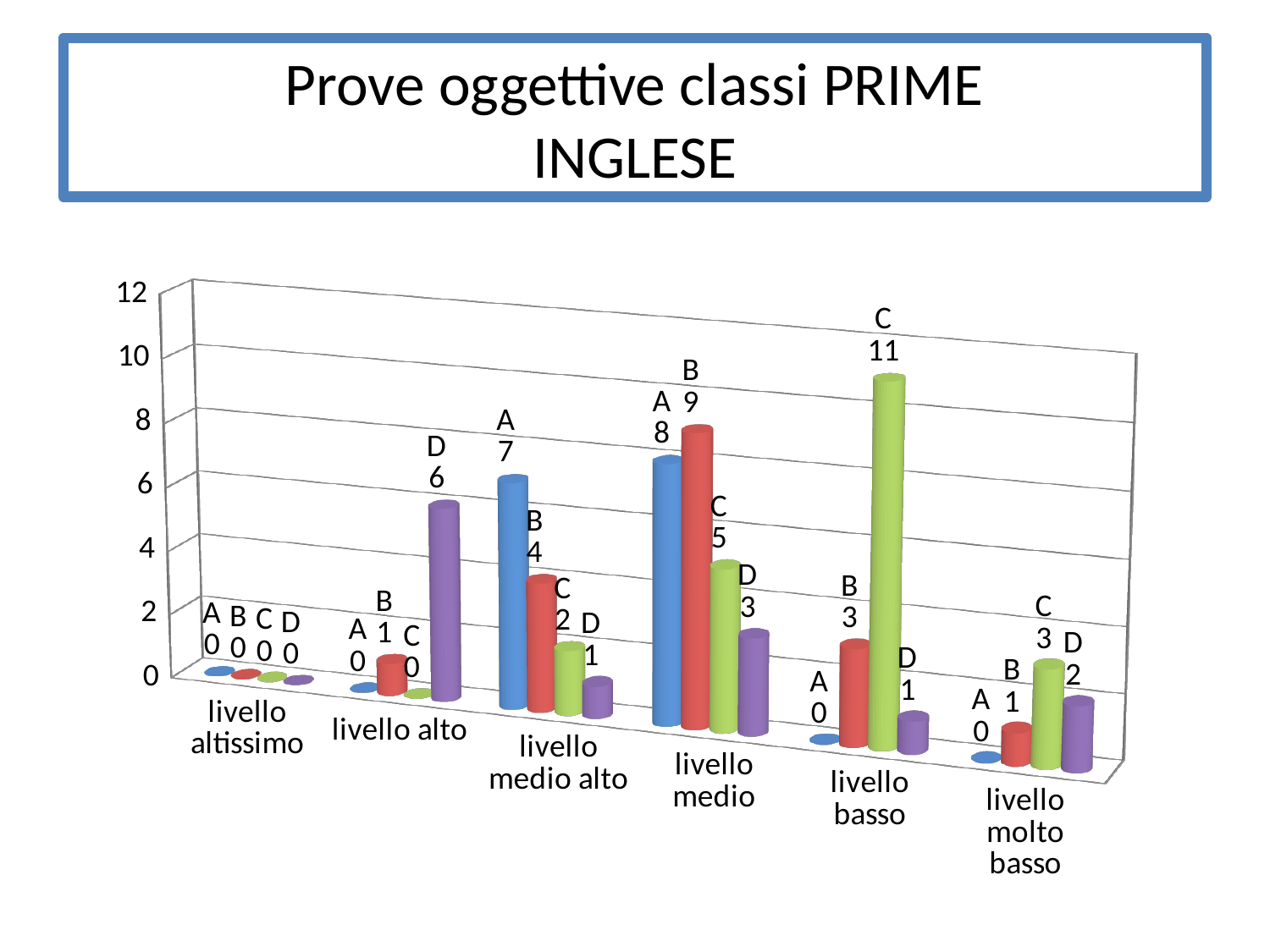
What is the difference between series B and series C at livello medio? 4 What kind of chart is shown on the slide? bar chart What is the value for series D at livello alto? 6 What is the value for series C at livello basso? 11 What is the value for series B at livello medio? 9 What is the title of the slide containing the chart? Prove oggettive classi PRIME INGLESE Which category has the highest value for series C? livello basso Which series has the highest value at livello medio? B How many categories are shown on the x axis? 6 What is the value for series A at livello medio alto? 7 What is the total of the four series at livello molto basso? 6 Which is larger at livello medio alto: series A or series B? A